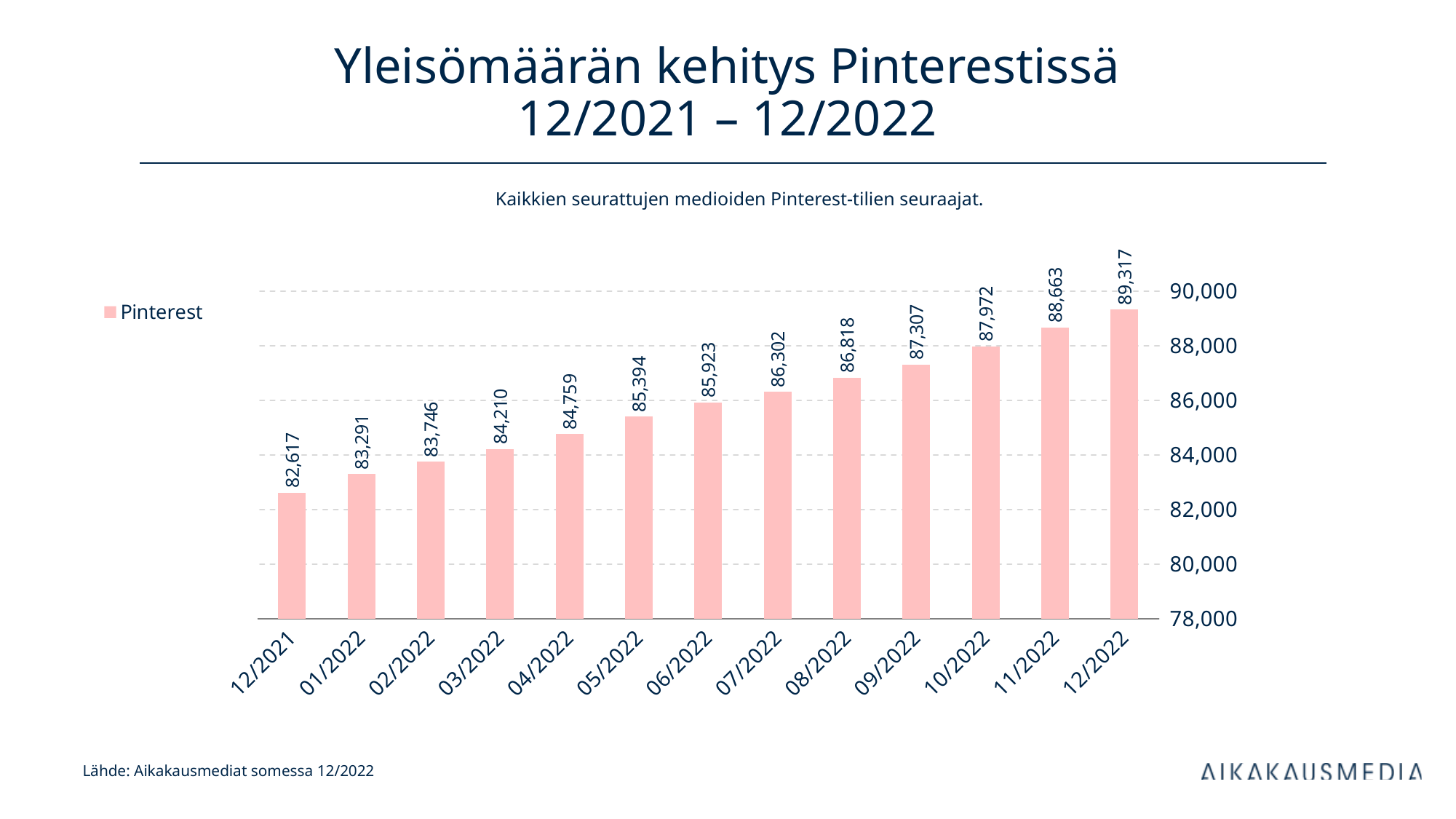
What is the value for 12/2022? 89,317 Which is larger, the value for 03/2022 or the value for 09/2022? 09/2022 Is the value for 10/2022 greater or less than 86,000? greater How many series does the legend list? 1 What is the difference between the values for 12/2022 and 12/2021? 6,700 Which month has the highest value? 12/2022 Do the values rise or fall from 12/2021 to 12/2022? rise What kind of chart is shown? bar chart Which month has the lowest value? 12/2021 How many months are shown on the x axis? 13 What is the value for 06/2022? 85,923 What is the value for 12/2021? 82,617